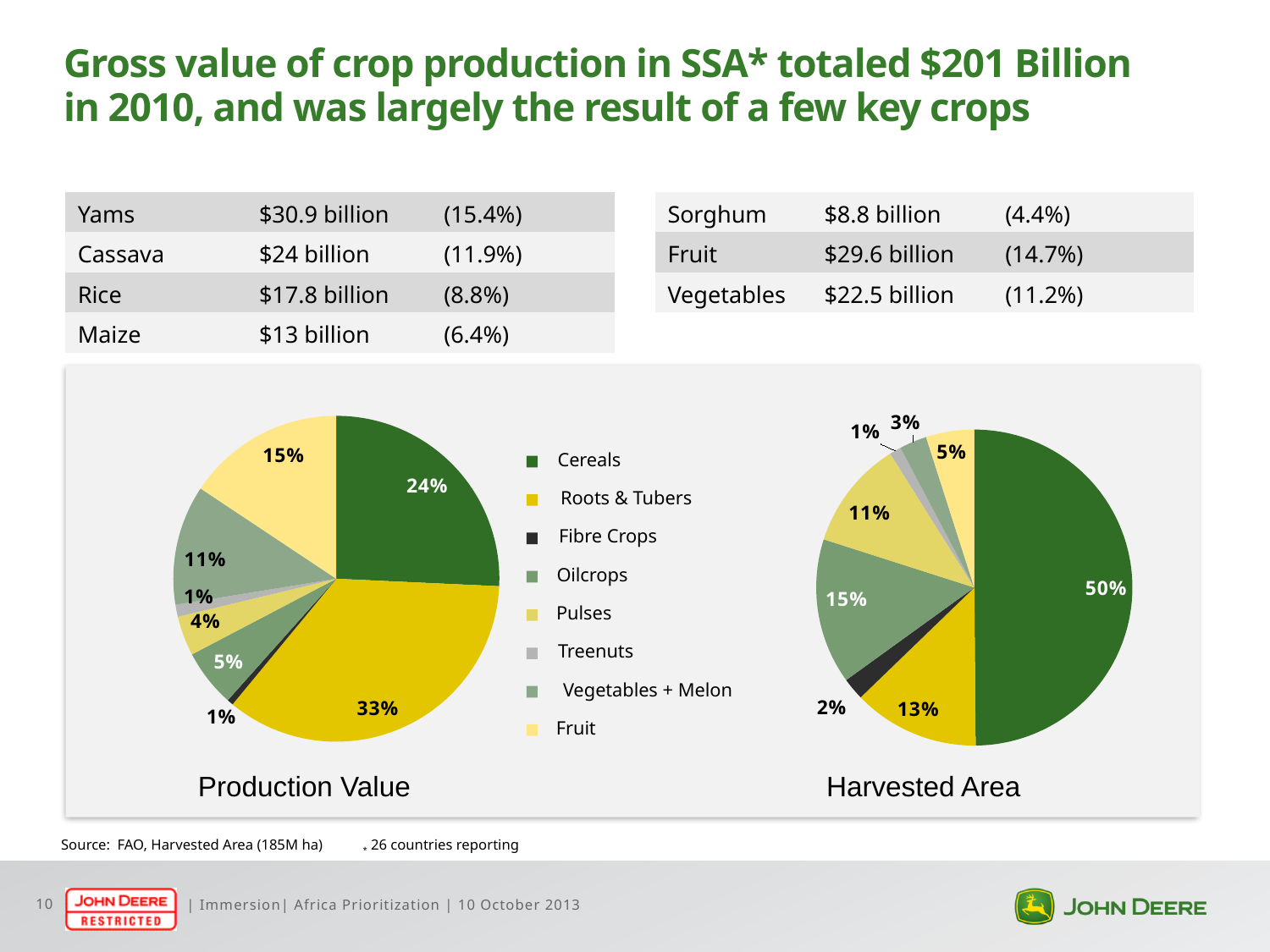
In the Harvested Area pie chart, which category has the smallest share? Treenuts How many categories does the legend list for the pie charts? 8 In the Harvested Area pie chart, what share is Oilcrops? 15% What type of chart is used for Production Value and Harvested Area? Pie chart In the Production Value pie chart, which category has the largest share? Roots & Tubers In the Production Value pie chart, what share is Roots & Tubers? 33% In the Harvested Area pie chart, what share is Cereals? 50% What is the difference between the Cereals share in the Harvested Area pie chart and the Cereals share in the Production Value pie chart? 26 percentage points In the Production Value pie chart, which is larger, the Fruit share or the Vegetables + Melon share? Fruit In the Harvested Area pie chart, what share is Roots & Tubers? 13% In the Production Value pie chart, what share is Cereals? 24% In the Harvested Area pie chart, which category has the largest share? Cereals